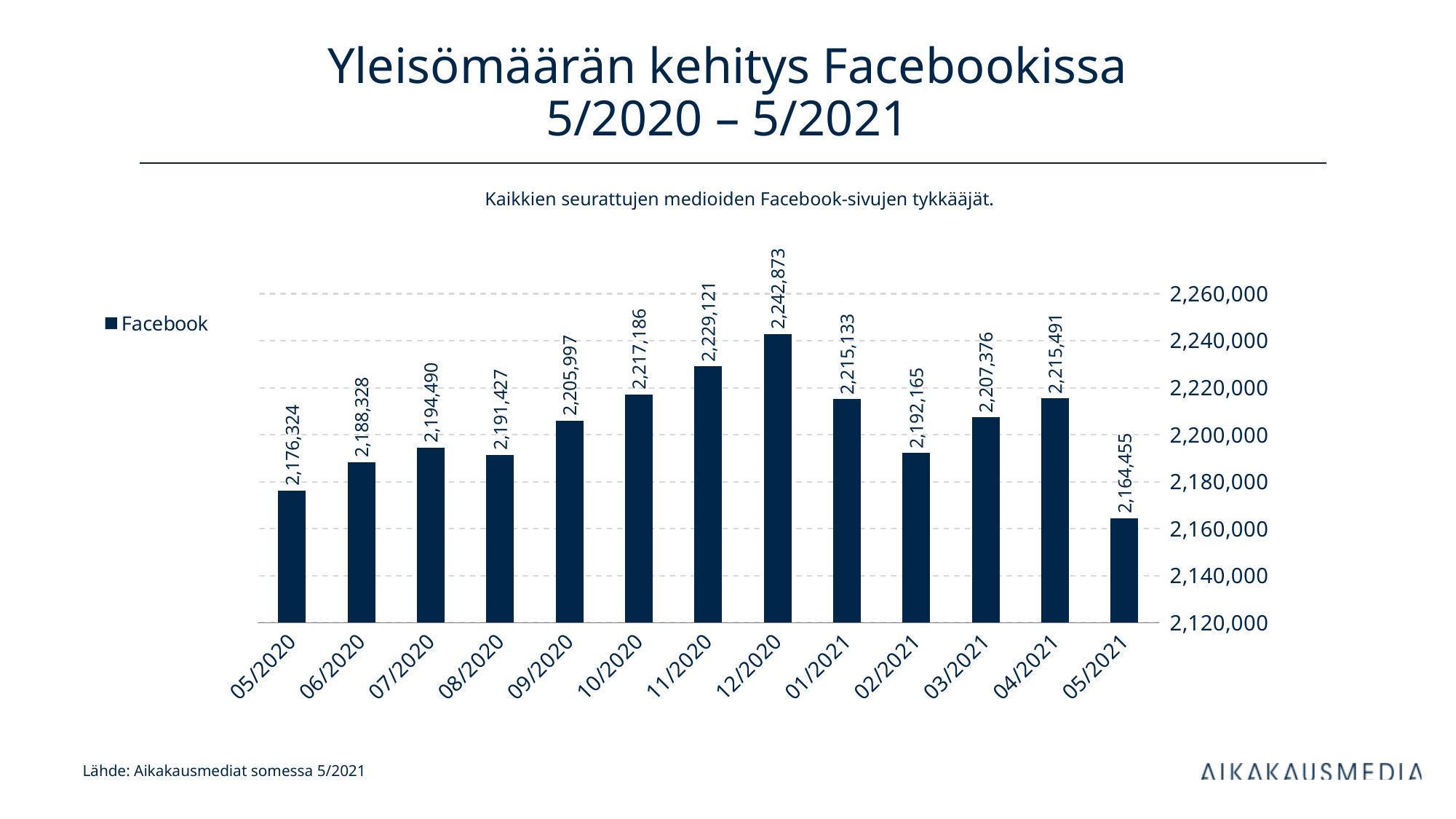
What is the value for 09/2020? 2,205,997 How many months are shown on the x axis? 13 What is the difference between the values for 11/2020 and 10/2020? 11,935 Is the value for 08/2020 greater or less than 2,200,000? less Which month has the highest value? 12/2020 What is the value for 12/2020? 2,242,873 What is the value for 05/2021? 2,164,455 What kind of chart is shown? bar chart Which is larger, the value for 03/2021 or the value for 02/2021? 03/2021 Which month has the lowest value? 05/2021 What is the difference between the values for 12/2020 and 05/2021? 78,418 What series does the legend list? Facebook